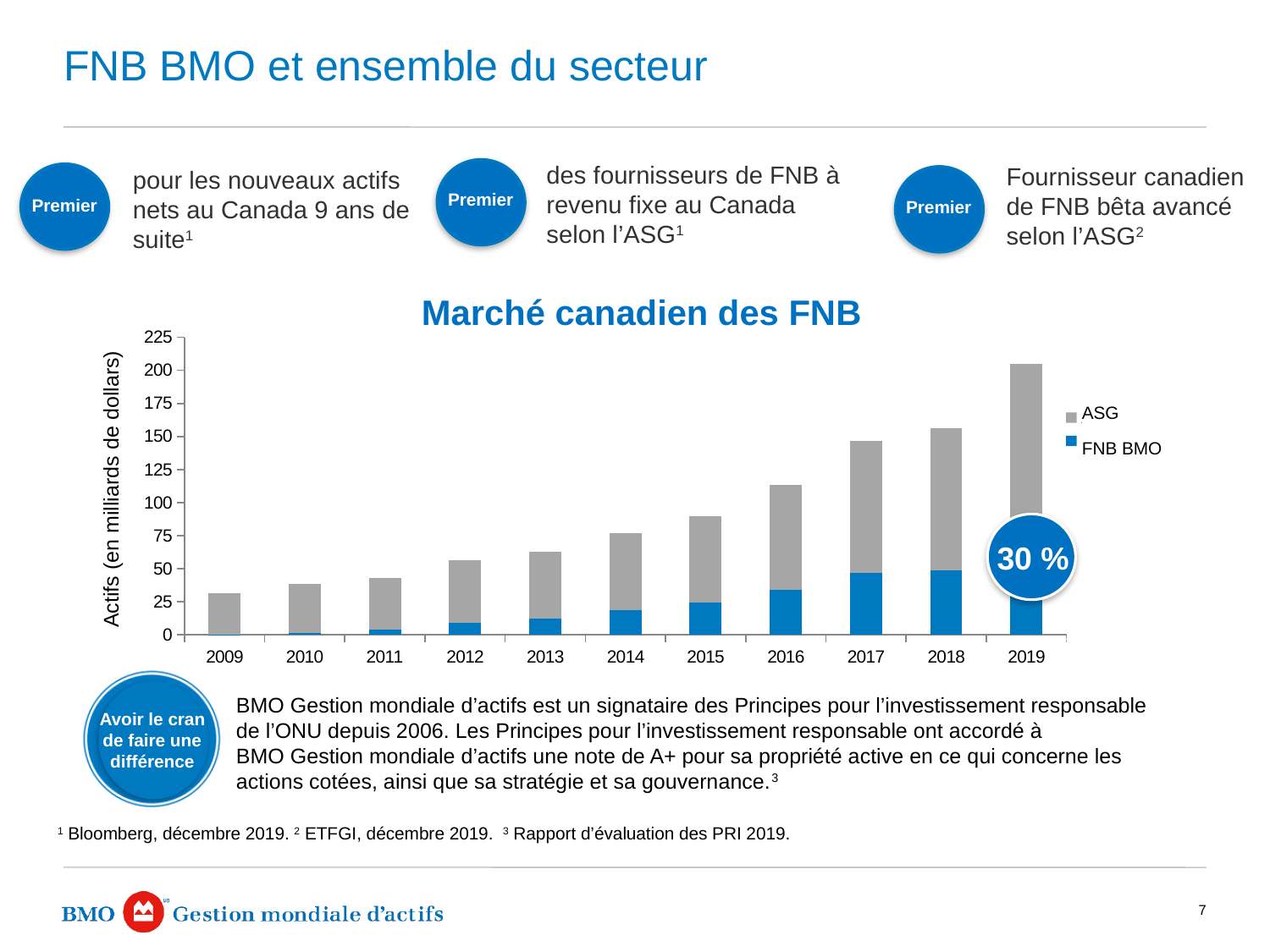
Which year has the lowest total bar in the chart? 2009 What is the title of the chart? Marché canadien des FNB How many series does the chart legend list? 2 Is the total value for 2019 greater or less than 175? greater Which series are listed in the chart legend? ASG and FNB BMO Is the total value for 2009 greater or less than 50? less Do the total bar values rise or fall from 2009 to 2019? Rise How many years are shown on the x axis of the chart? 11 Is the total value for 2016 greater or less than 100? greater Which year has the highest total bar in the chart? 2019 Which year has the larger FNB BMO value, 2012 or 2015? 2015 What kind of chart is shown on the slide? Stacked bar chart